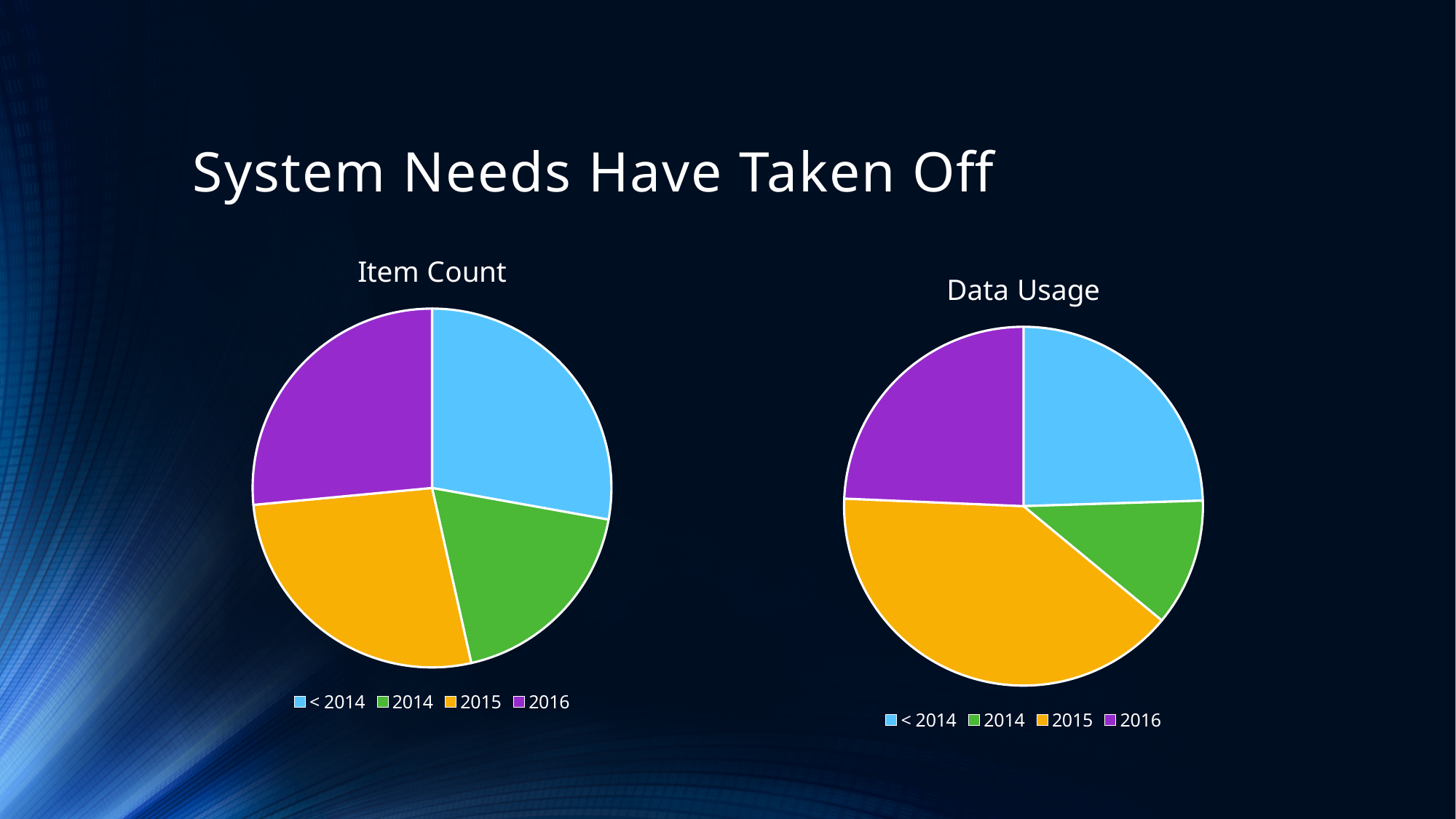
In the Data Usage chart, which category has the smallest slice? 2014 What is the title of the chart on the right of the slide? Data Usage In the Data Usage chart, which slice is larger: 2014 or < 2014? < 2014 In the Data Usage chart, which category has the largest slice? 2015 How many slices does the Item Count pie chart have? 4 In the Item Count chart, what colour represents the 2015 slice? orange How many entries does the legend of the Data Usage chart list? 4 In the Item Count chart, which slice is larger: < 2014 or 2014? < 2014 In the Data Usage chart, which slice is larger: 2015 or 2016? 2015 What kind of chart is the Item Count chart? pie chart What kind of chart is the Data Usage chart? pie chart In the Item Count chart, which category has the smallest slice? 2014